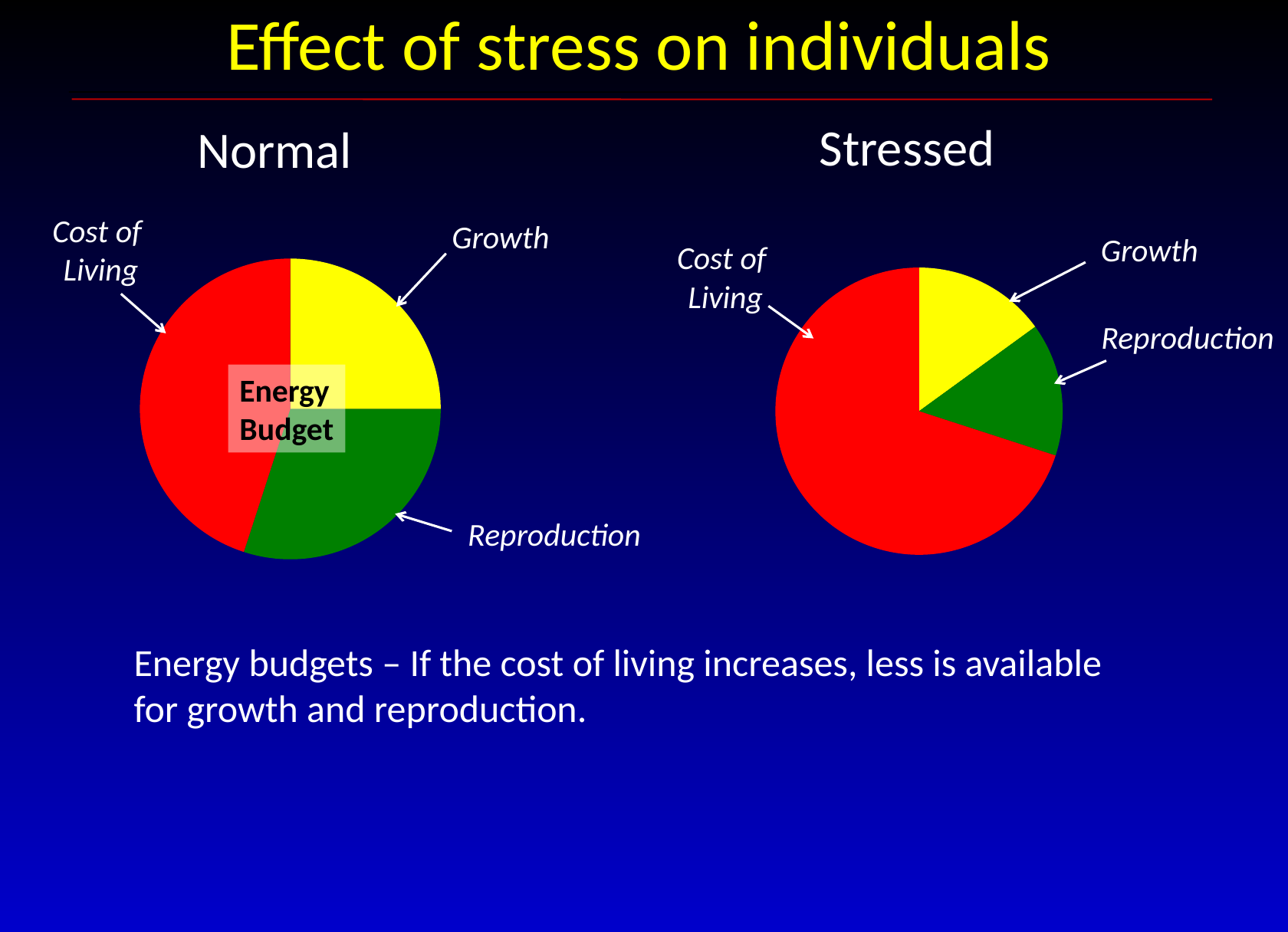
In the Stressed pie chart, which category has the largest slice? Cost of Living What colour is the Cost of Living slice in the Stressed pie chart? red What text is printed in the centre of the Normal pie chart? Energy Budget Is the Growth slice larger in the Normal pie chart or the Stressed pie chart? Normal In the Normal pie chart, which category has the largest slice? Cost of Living Is the Cost of Living slice larger in the Normal pie chart or the Stressed pie chart? Stressed What kind of chart is the Normal chart? pie chart In the Normal pie chart, which slice is larger, Growth or Reproduction? Reproduction In the Normal pie chart, which category has the smallest slice? Growth How many slices does the Stressed pie chart have? 3